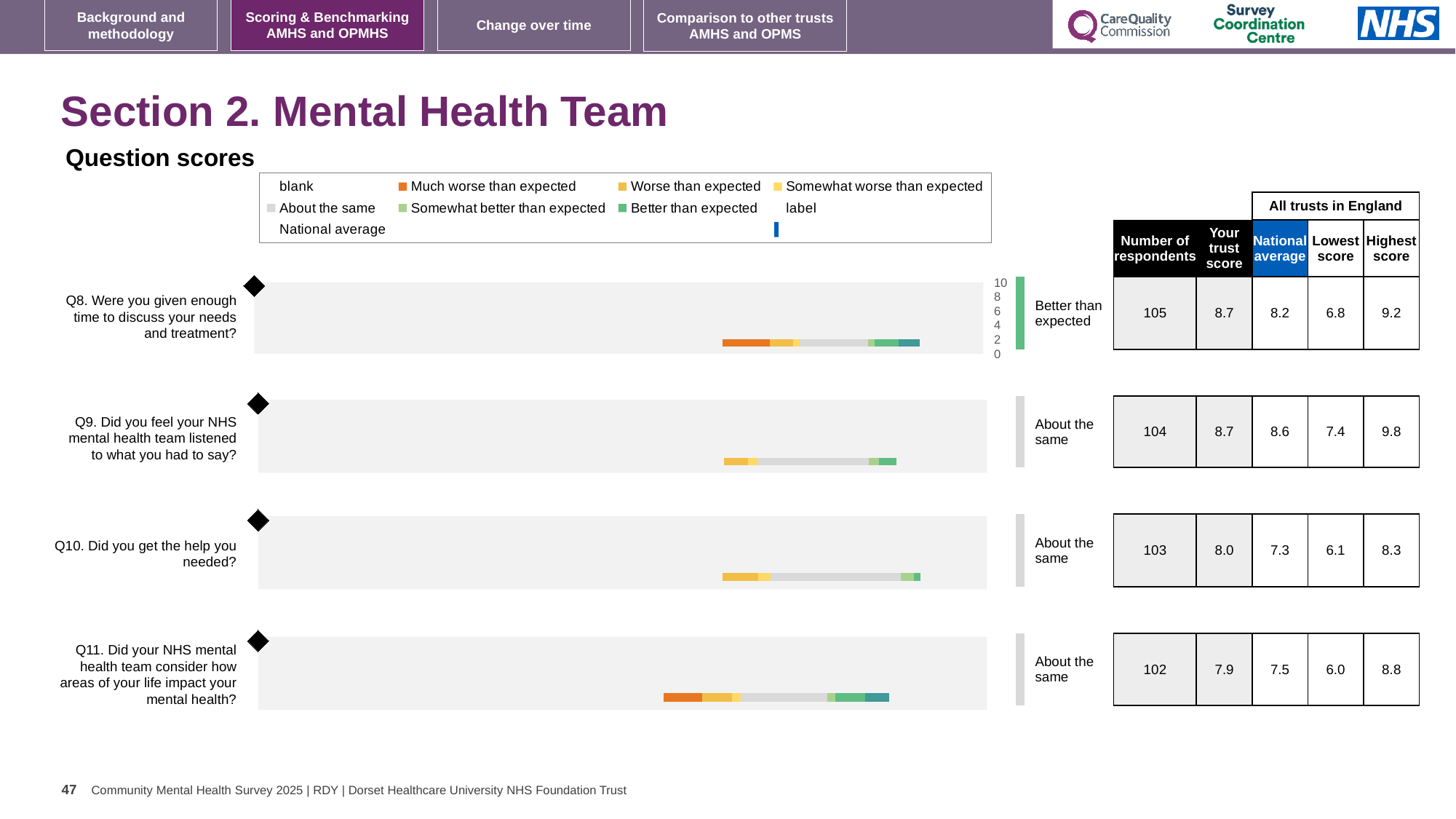
Which question has the lowest national average score on this slide? Q10 What kind of chart is used to show the question scores on this slide? Bar chart What is the highest score among all trusts in England for Q9 (Did you feel your NHS mental health team listened to what you had to say)? 9.8 How many respondents answered Q11 (Did your NHS mental health team consider how areas of your life impact your mental health)? 102 For Q10, what is the difference between the trust score and the national average? 0.7 For Q8, what is the difference between the highest score and the lowest score among all trusts in England? 2.4 What is the national average score for Q10 (Did you get the help you needed)? 7.3 For Q9, which is larger: the trust score or the national average? The trust score (8.7) What benchmark category is shown for Q8 (Were you given enough time to discuss your needs and treatment)? Better than expected Which question has the lowest 'Your trust score' on this slide? Q11 What is the 'Your trust score' value for Q8 (Were you given enough time to discuss your needs and treatment)? 8.7 How many questions are charted on this slide? 4